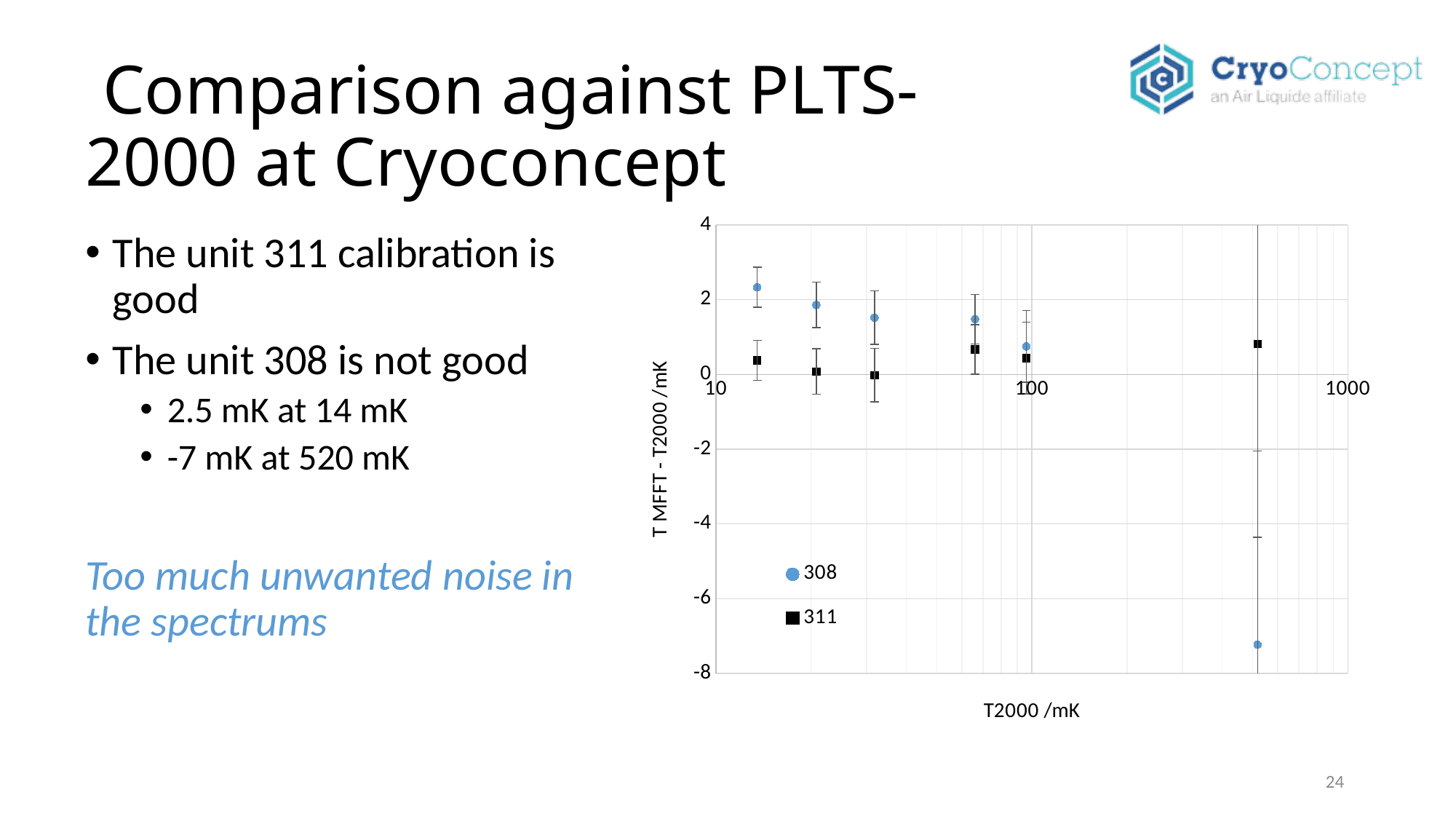
How many data points are plotted for series 311? 6 Is the value of the rightmost 311 point (near 500 mK) greater or less than 0? greater How many series does the chart legend list? 2 Do the values of series 308 rise or fall as T2000 increases along the x axis? fall What is the title of the chart's x axis? T2000 /mK How many data points are plotted for series 308? 6 At the rightmost x position, which series has the larger value, 308 or 311? 311 What kind of chart is shown on the slide? scatter chart Is the value of the rightmost 308 point (near 500 mK) greater or less than -6? less Is the value of the leftmost 308 point greater or less than 0? greater At the leftmost x position, which series has the larger value, 308 or 311? 308 What are the two series named in the chart legend? 308 and 311